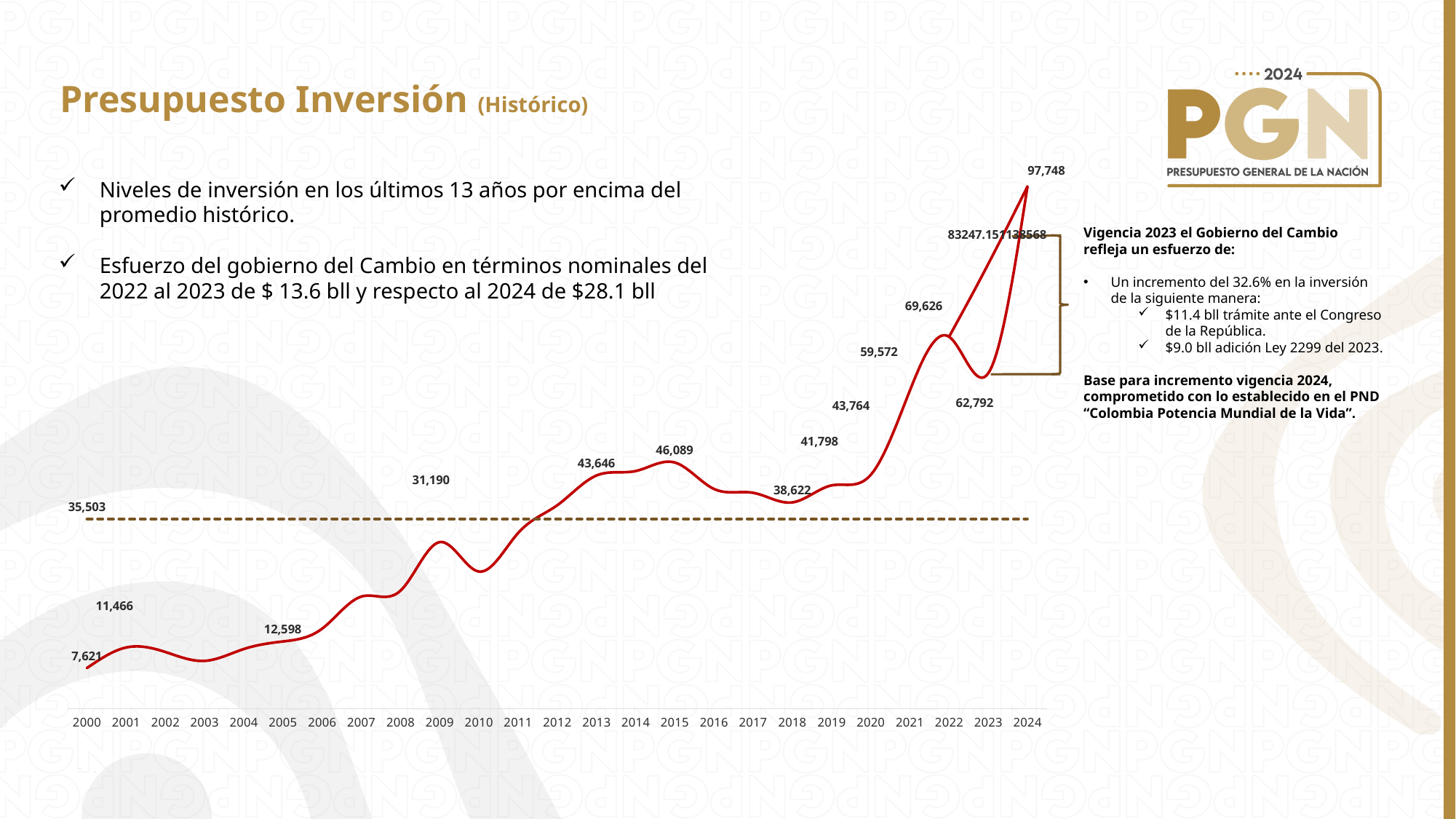
What type of chart is shown on the slide? line chart Which year has the lowest value on the chart? 2000 What value is marked by the dashed horizontal line on the chart? 35,503 Overall, do the values rise or fall from 2000 to 2024? rise What is the investment budget value shown for 2024? 97,748 Which year has the highest value on the chart? 2024 What is the title of the slide containing the chart? Presupuesto Inversión (Histórico) Is the value for 2010 greater or less than 35,503? less What is the difference between the 2024 value and the 2000 value? 90,127 How many years are shown on the x axis of the chart? 25 Is the value for 2021 greater or less than 35,503? greater What is the investment budget value shown for 2000? 7,621